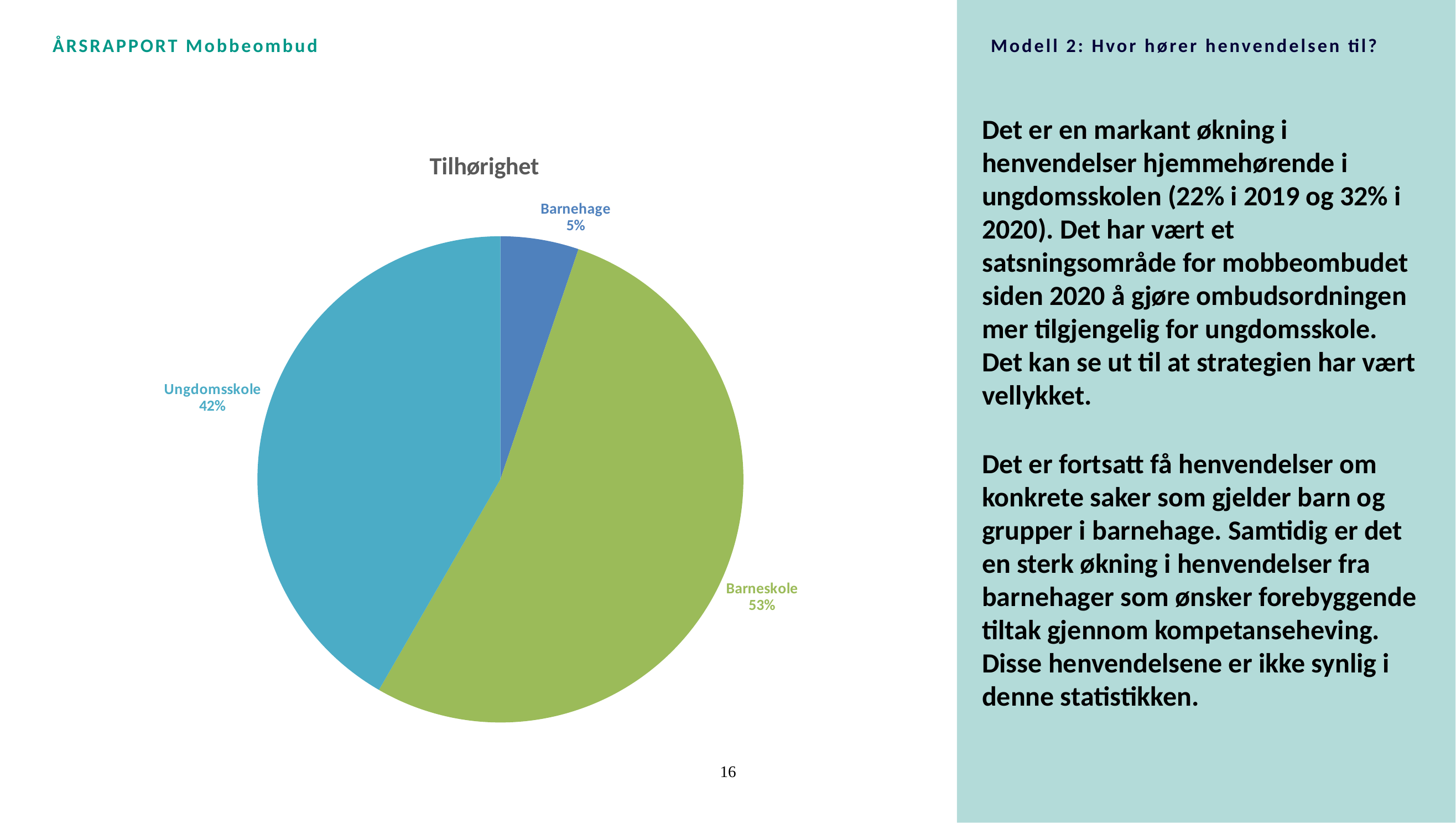
How many categories are shown in the pie chart? 3 What colour is the Barneskole slice? Green What is the title of the chart? Tilhørighet Which category has the largest slice of the pie? Barneskole What share of the pie does Ungdomsskole have? 42% What kind of chart is shown on the slide? Pie chart What share of the pie does Barnehage have? 5% Which category has the smallest slice of the pie? Barnehage What is the difference in percentage points between Barneskole and Ungdomsskole? 11 Which is larger, the share for Ungdomsskole or the share for Barnehage? Ungdomsskole What share of the pie does Barneskole have? 53% What is the difference in percentage points between Ungdomsskole and Barnehage? 37